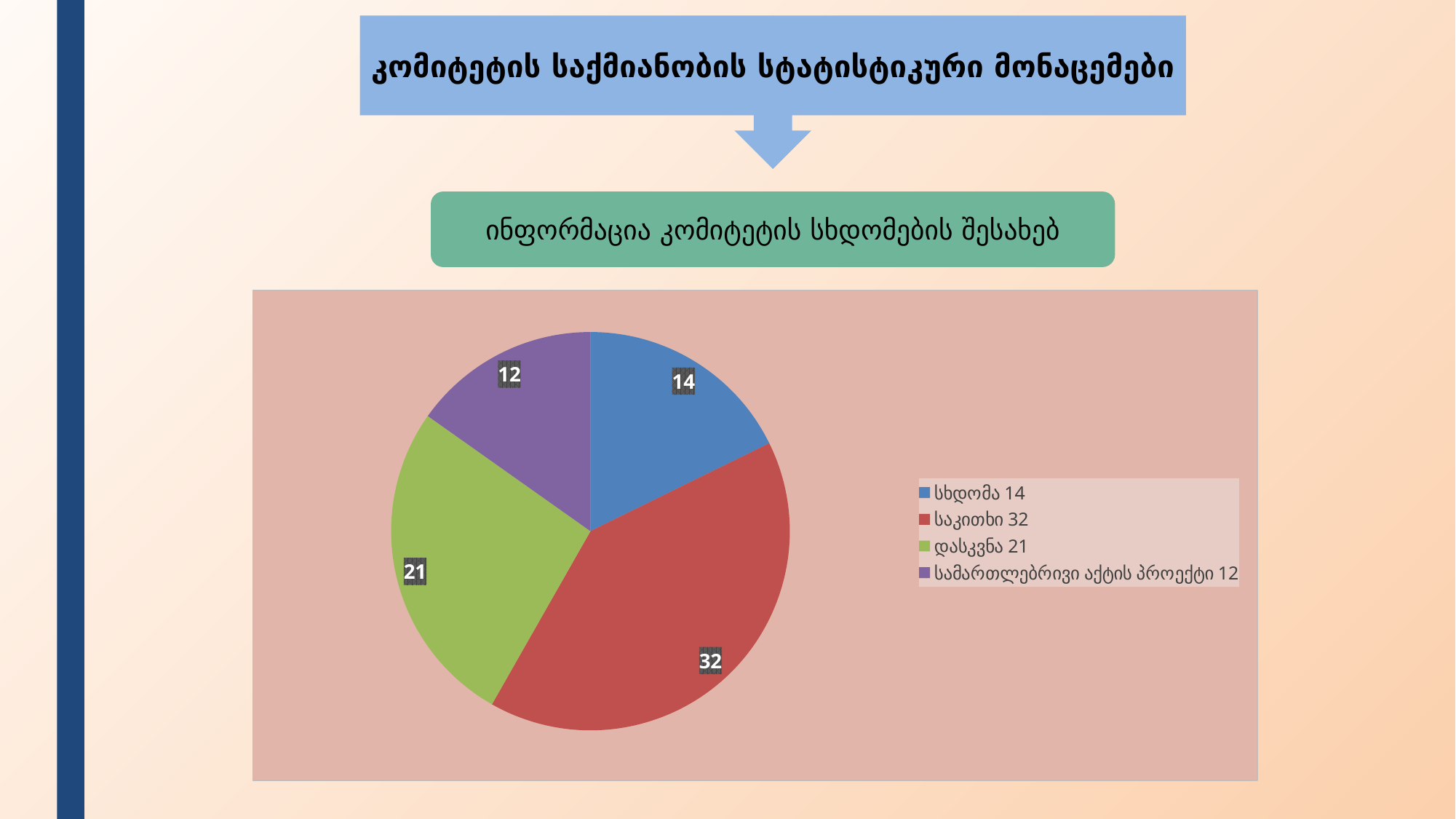
What is the value of the slice labelled სხდომა in the pie chart? 14 What is the difference between the საკითხი slice and the დასკვნა slice? 11 What is the value of the slice labelled საკითხი in the pie chart? 32 What type of chart is shown on the slide? pie chart What is the total of all four slice values in the pie chart? 79 Which is larger in the pie chart, სხდომა or დასკვნა? დასკვნა What is the value of the slice labelled დასკვნა in the pie chart? 21 What colour is the საკითხი slice in the pie chart? red Which category has the largest slice in the pie chart? საკითხი Which category has the smallest slice in the pie chart? სამართლებრივი აქტის პროექტი How many slices does the pie chart have? 4 What is the value of the slice labelled სამართლებრივი აქტის პროექტი in the pie chart? 12